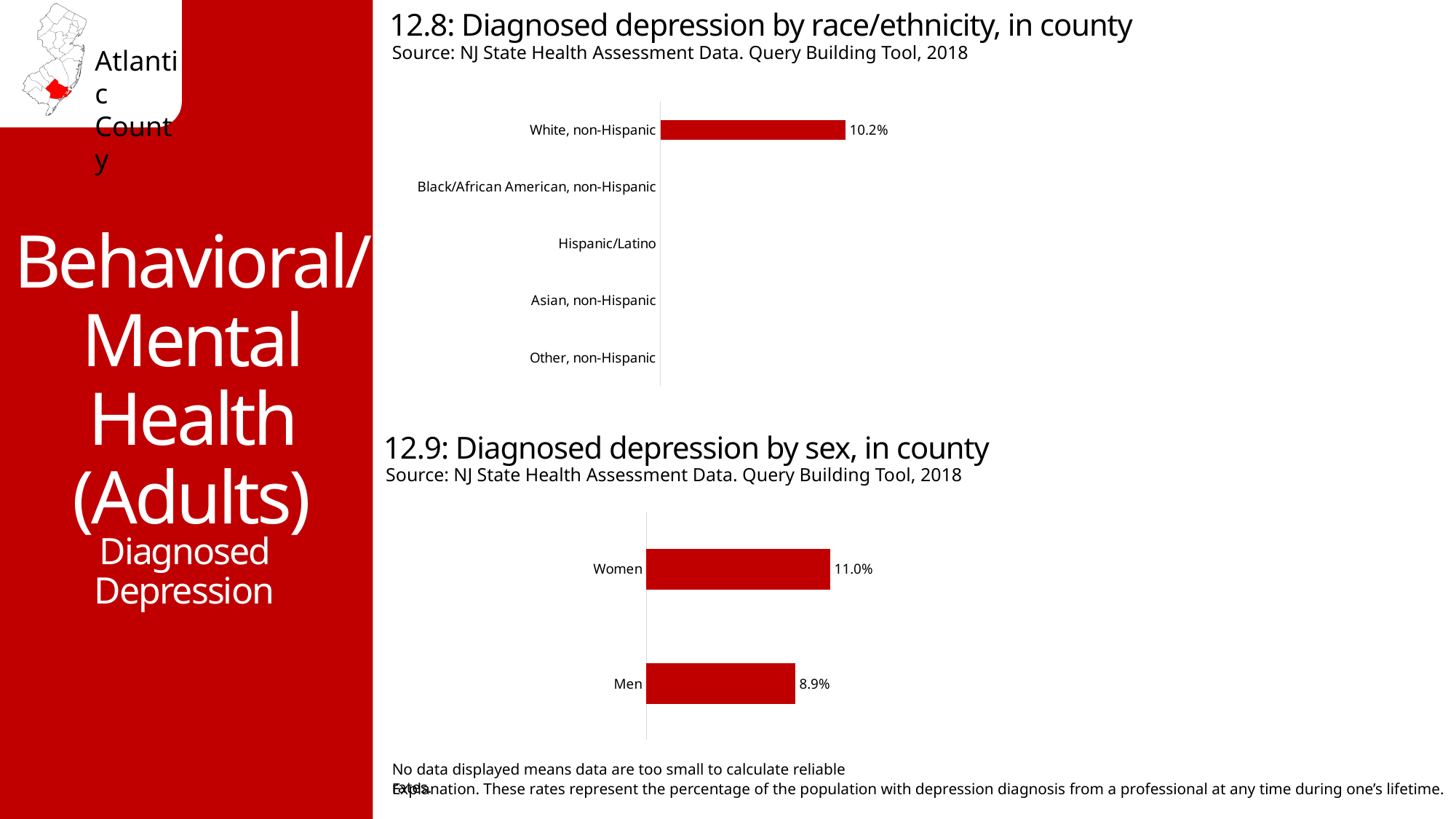
What kind of chart is '12.8: Diagnosed depression by race/ethnicity, in county'? Bar chart In the chart '12.9: Diagnosed depression by sex, in county', is the value for Women larger or smaller than the value for Men? Larger In the chart '12.9: Diagnosed depression by sex, in county', which category has the lower value? Men In the chart '12.8: Diagnosed depression by race/ethnicity, in county', which category is the only one with a bar displayed? White, non-Hispanic In the chart '12.9: Diagnosed depression by sex, in county', how many categories are shown? 2 In the chart '12.9: Diagnosed depression by sex, in county', what is the difference between the values for Women and Men? 2.1% In the chart '12.9: Diagnosed depression by sex, in county', which category has the higher value? Women In the chart '12.9: Diagnosed depression by sex, in county', what is the value for Men? 8.9% In the chart '12.9: Diagnosed depression by sex, in county', what is the value for Women? 11.0% In the chart '12.8: Diagnosed depression by race/ethnicity, in county', what is the value for White, non-Hispanic? 10.2% What kind of chart is '12.9: Diagnosed depression by sex, in county'? Bar chart In the chart '12.8: Diagnosed depression by race/ethnicity, in county', how many race/ethnicity categories are listed on the axis? 5